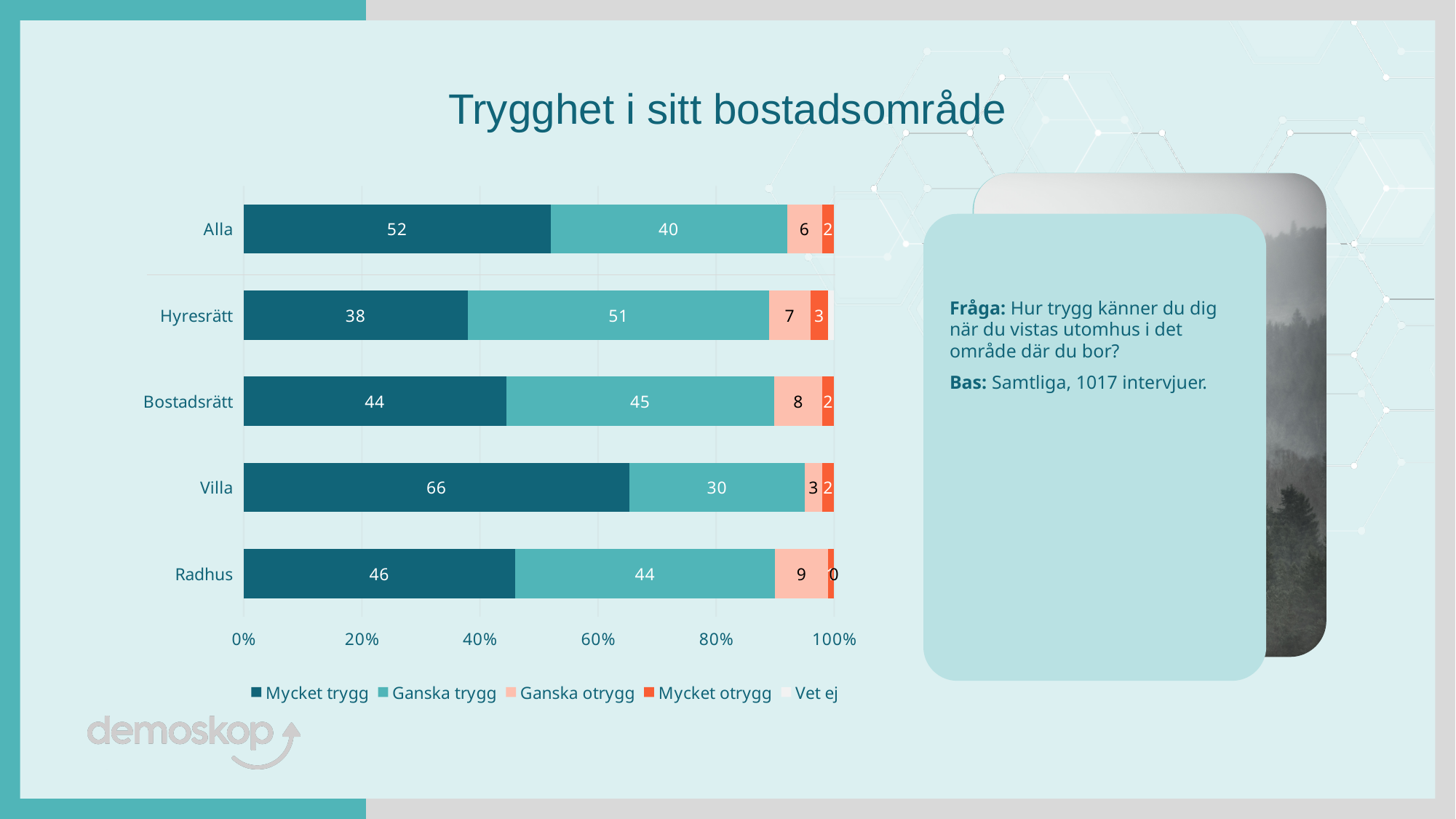
What is the value of Ganska trygg for Hyresrätt? 51 How many categories are shown on the chart? 5 Which has a larger Ganska trygg value, Bostadsrätt or Alla? Bostadsrätt What is the difference between the Mycket trygg values for Villa and Hyresrätt? 28 What is the value of Mycket otrygg for Hyresrätt? 3 What is the value of Ganska otrygg for Radhus? 9 Which category has the highest value for Mycket trygg? Villa What is the value of Mycket trygg for Villa? 66 Which category has the lowest value for Mycket trygg? Hyresrätt Which category has the highest value for Ganska otrygg? Radhus How many series does the legend list? 5 What kind of chart is shown on the slide? Stacked bar chart